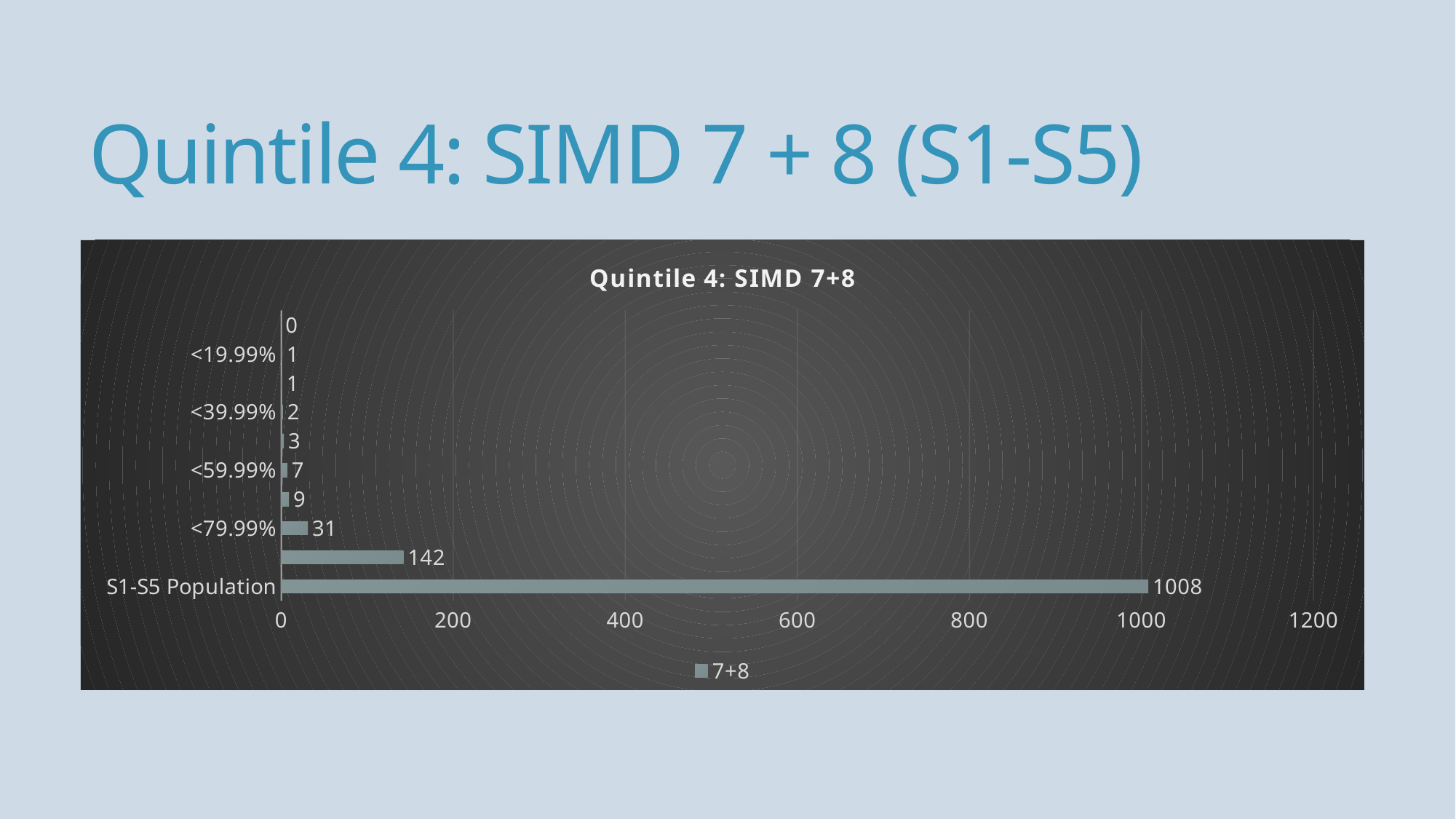
What is the value for the <59.99% category? 7 What is the value for S1-S5 Population? 1008 What is the difference between the values for S1-S5 Population and <79.99%? 977 What kind of chart is shown? Bar chart Which category has the highest value? S1-S5 Population What is the value for the <19.99% category? 1 Is the value for S1-S5 Population greater or less than 1000? greater What is the difference between the values for <79.99% and <59.99%? 24 How many bars are plotted in the chart? 10 What is the value for the <79.99% category? 31 Which is larger, the value for <79.99% or the value for <59.99%? <79.99% What is the value for the <39.99% category? 2